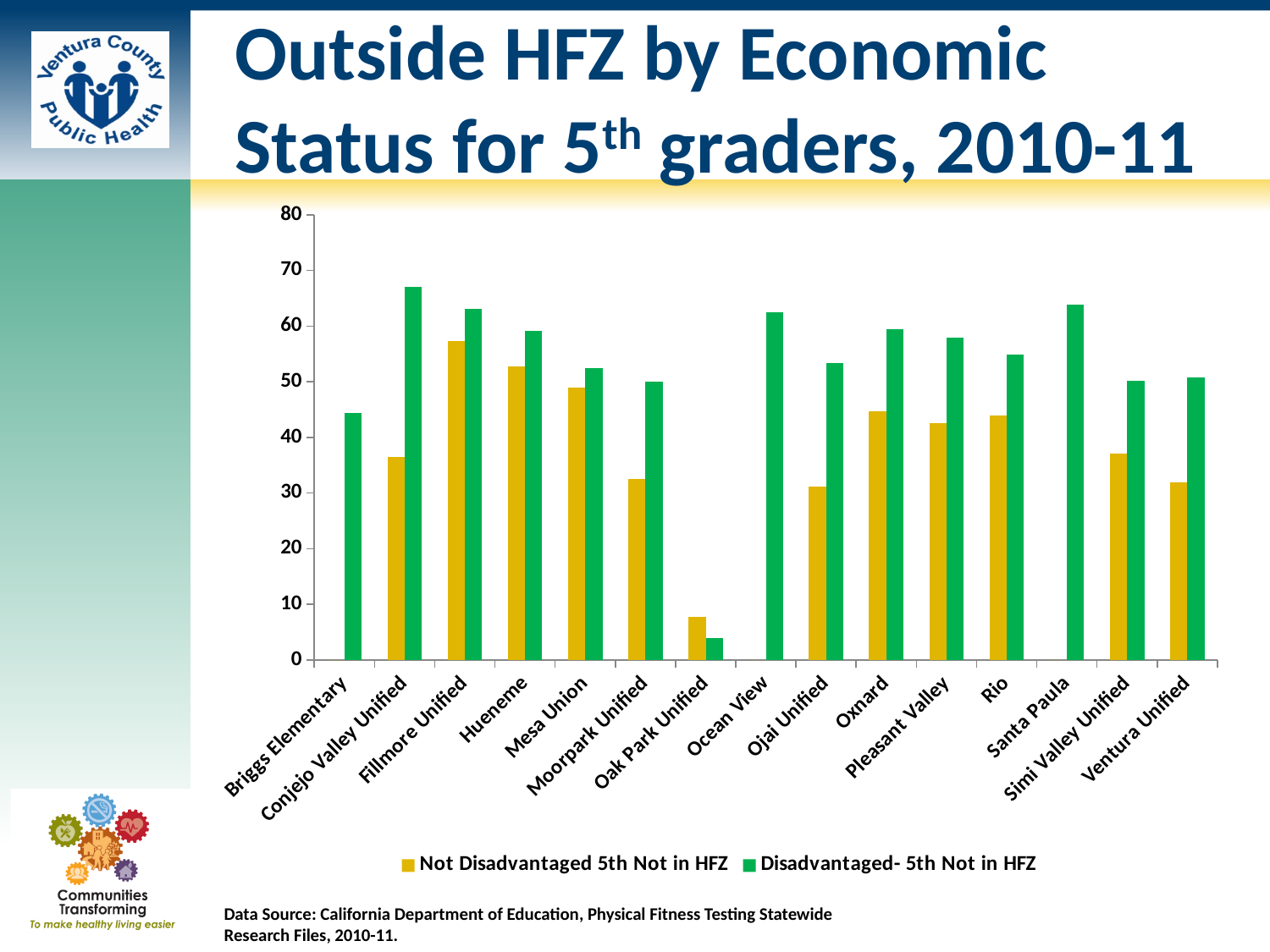
Is the Not Disadvantaged 5th Not in HFZ value for Moorpark Unified greater or less than 40? less Which district has the lowest value for Disadvantaged- 5th Not in HFZ? Oak Park Unified Which district has the highest value for Not Disadvantaged 5th Not in HFZ? Fillmore Unified How many school districts are shown on the x axis? 15 Which colour represents the Disadvantaged- 5th Not in HFZ series? green How many series does the legend list? 2 For Conejo Valley Unified, which series has the larger value: Not Disadvantaged 5th Not in HFZ or Disadvantaged- 5th Not in HFZ? Disadvantaged- 5th Not in HFZ What kind of chart is shown on the slide? bar chart Is the Disadvantaged- 5th Not in HFZ value for Conejo Valley Unified greater or less than 60? greater Which district has the highest value for Disadvantaged- 5th Not in HFZ? Conjejo Valley Unified For Oak Park Unified, which series has the larger value: Not Disadvantaged 5th Not in HFZ or Disadvantaged- 5th Not in HFZ? Not Disadvantaged 5th Not in HFZ Is the Not Disadvantaged 5th Not in HFZ value for Oak Park Unified greater or less than 10? less